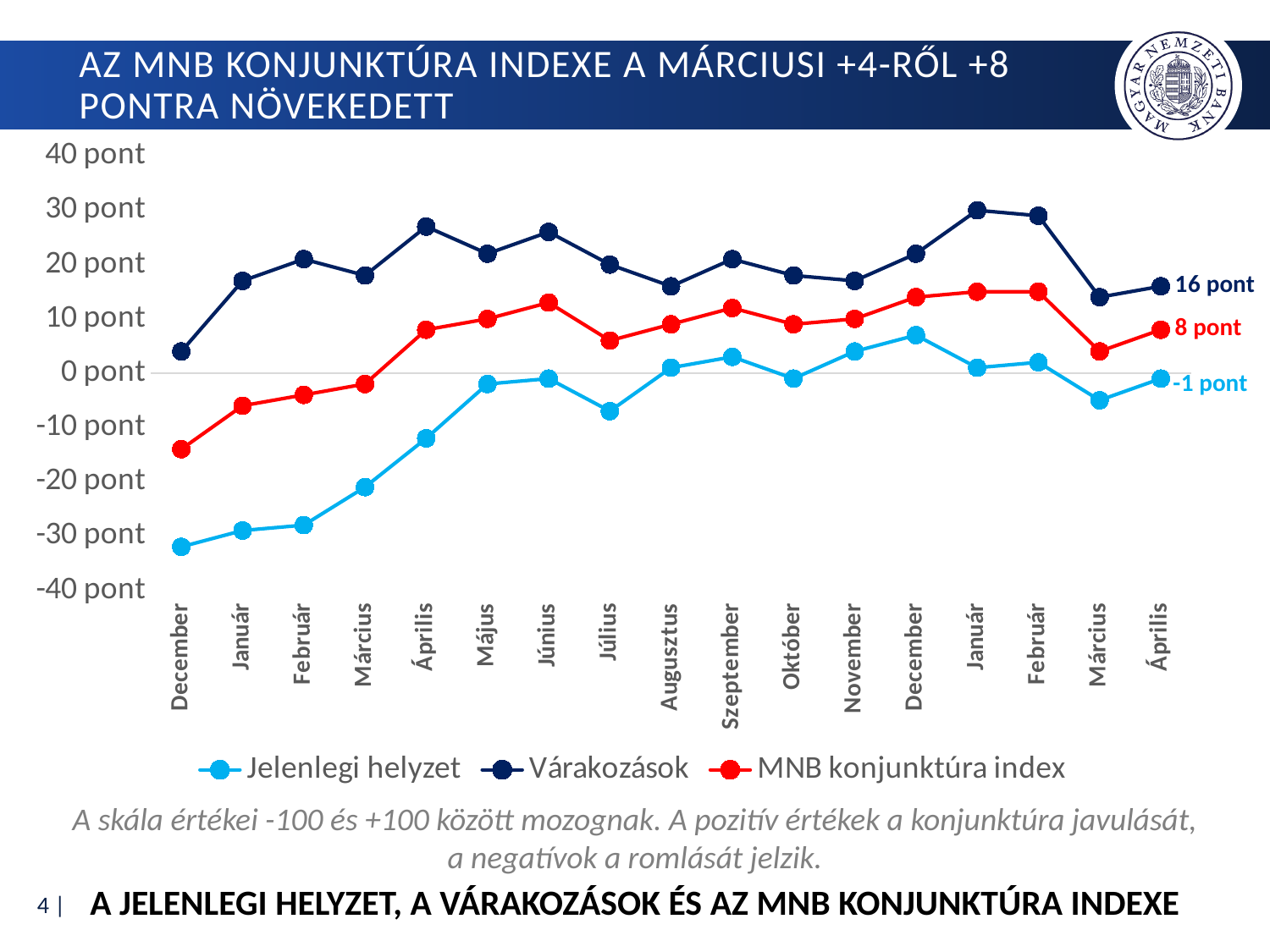
In the final Április, how much higher is Várakozások than the MNB konjunktúra index? 8 pont In the final Április, which is larger: Várakozások or Jelenlegi helyzet? Várakozások Which series has the lowest value in the first December? Jelenlegi helyzet How many series does the legend list? 3 What is the value of Jelenlegi helyzet in the final Április? -1 pont What is the value of the MNB konjunktúra index in the final Április? 8 pont Is the value of Jelenlegi helyzet in the first December greater or less than -20 pont? less Is the value of Várakozások in the second Január greater or less than 20 pont? greater What kind of chart is shown on the slide? line chart How many months are plotted along the x axis? 17 What is the value of Várakozások in the final Április? 16 pont What colour is the MNB konjunktúra index line? red